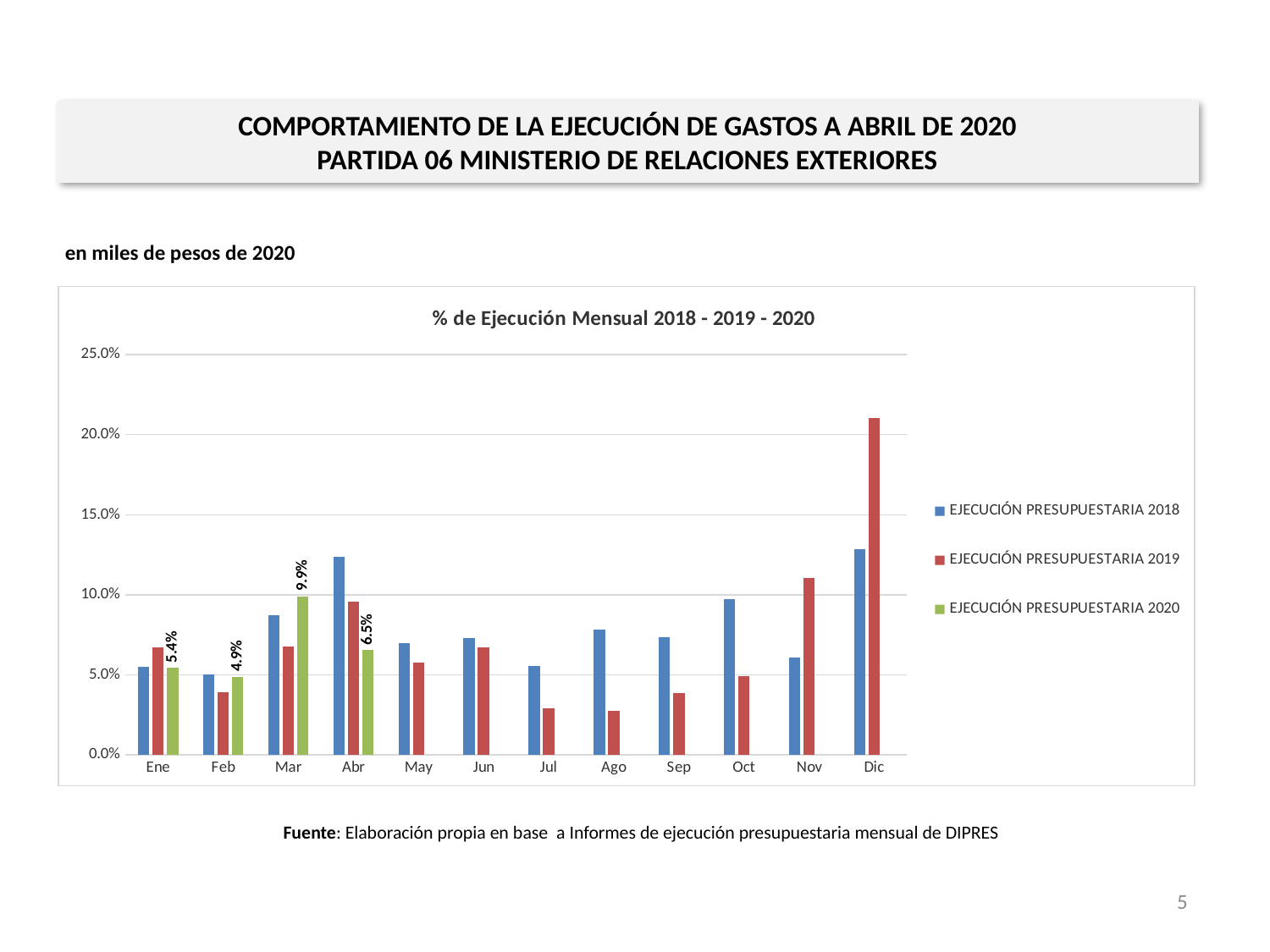
What type of chart is shown on the slide? bar chart What is the difference between the EJECUCIÓN PRESUPUESTARIA 2020 values for Mar and Feb? 5.0% What is the value for EJECUCIÓN PRESUPUESTARIA 2020 in Mar? 9.9% Is the value for EJECUCIÓN PRESUPUESTARIA 2019 in Dic greater or less than 20.0%? greater In which month is the EJECUCIÓN PRESUPUESTARIA 2020 value lowest? Feb Is the value for EJECUCIÓN PRESUPUESTARIA 2019 in Ago greater or less than 5.0%? less What is the value for EJECUCIÓN PRESUPUESTARIA 2020 in Abr? 6.5% How many series does the legend list? 3 What is the title of the chart? % de Ejecución Mensual 2018 - 2019 - 2020 How many months are shown on the x axis? 12 What is the value for EJECUCIÓN PRESUPUESTARIA 2020 in Ene? 5.4% In which month is the EJECUCIÓN PRESUPUESTARIA 2020 value highest? Mar